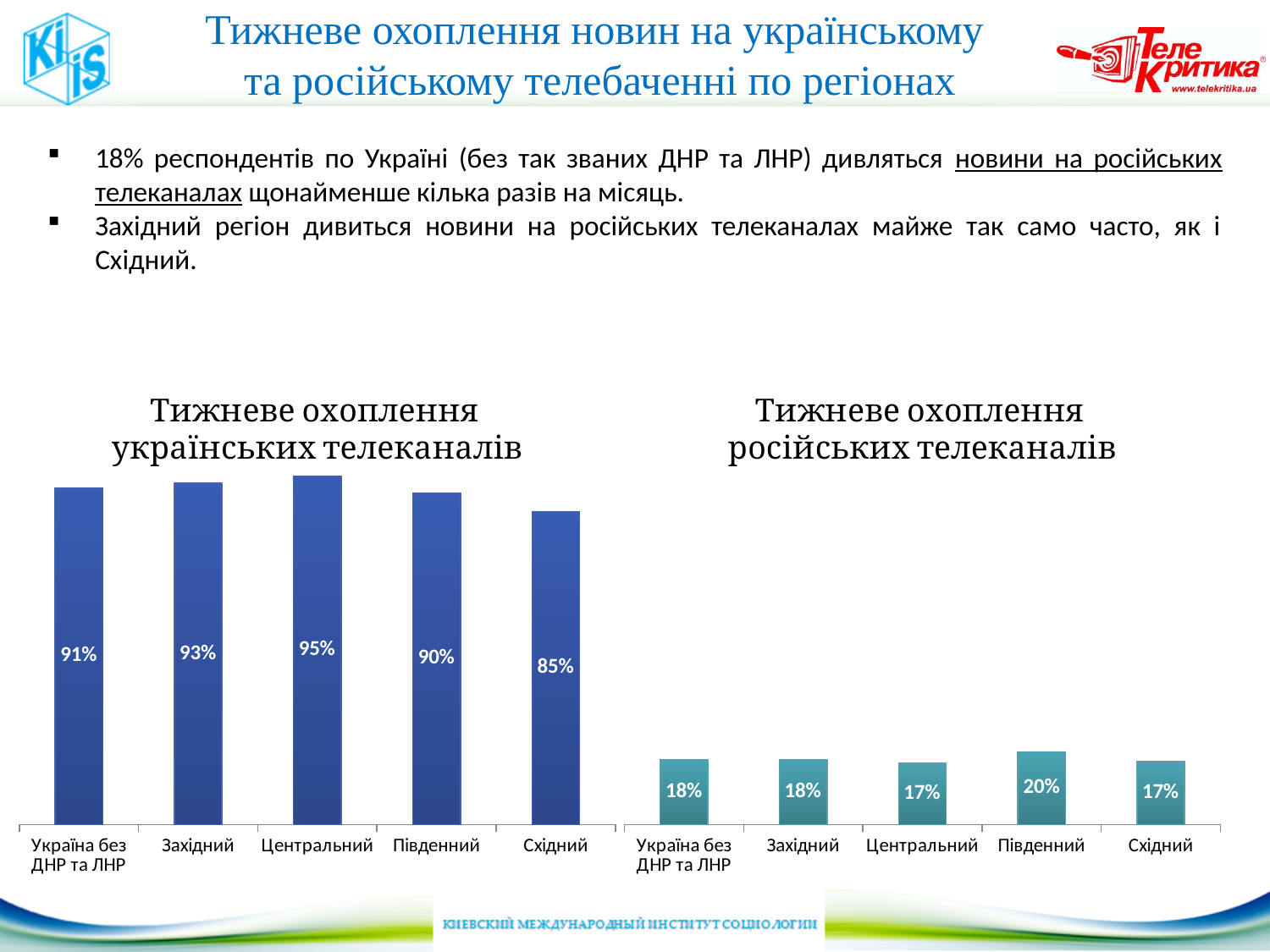
In the chart titled "Тижневе охоплення українських телеканалів", what is the difference between the values for Центральний and Східний? 10% What kind of chart is the chart titled "Тижневе охоплення українських телеканалів"? Bar chart In the chart titled "Тижневе охоплення українських телеканалів", which is larger: the value for Західний or the value for Південний? Західний How many charts are shown on the slide? 2 In the chart titled "Тижневе охоплення українських телеканалів", which category has the lowest value? Східний In the chart titled "Тижневе охоплення російських телеканалів", what is the value for Південний? 20% How many categories are shown in the chart titled "Тижневе охоплення російських телеканалів"? 5 In the chart titled "Тижневе охоплення російських телеканалів", what is the difference between the values for Південний and Центральний? 3% In the chart titled "Тижневе охоплення українських телеканалів", what is the value for Україна без ДНР та ЛНР? 91% In the chart titled "Тижневе охоплення російських телеканалів", which category has the highest value? Південний In the chart titled "Тижневе охоплення українських телеканалів", which category has the highest value? Центральний In the chart titled "Тижневе охоплення українських телеканалів", what is the value for Центральний? 95%